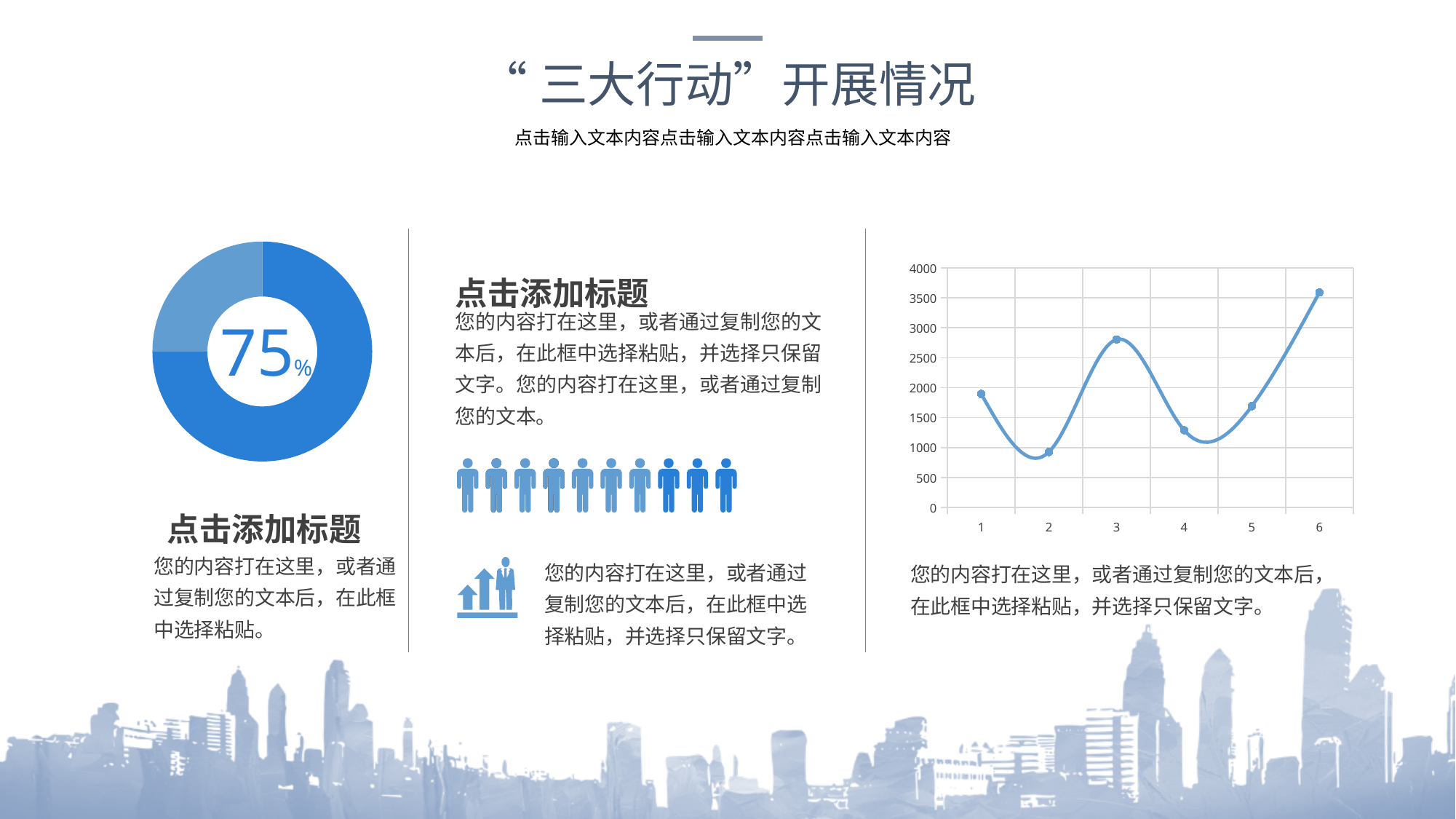
On the line chart, which is larger, the value at x = 1 or the value at x = 5? x = 1 On the line chart, does the value rise or fall from x = 3 to x = 4? fall On the line chart, is the value at x = 3 greater or less than 2500? greater How many points are plotted on the line chart on the right? 6 What kind of chart is on the right side of the slide? line chart What percentage is shown in the centre of the donut chart on the left? 75% On the line chart, is the value at x = 2 greater or less than 1000? less On the line chart, which x-axis category has the lowest value? 2 What is the highest value shown on the vertical axis of the line chart? 4000 On the line chart, is the value at x = 6 greater or less than 3500? greater On the line chart, which x-axis category has the highest value? 6